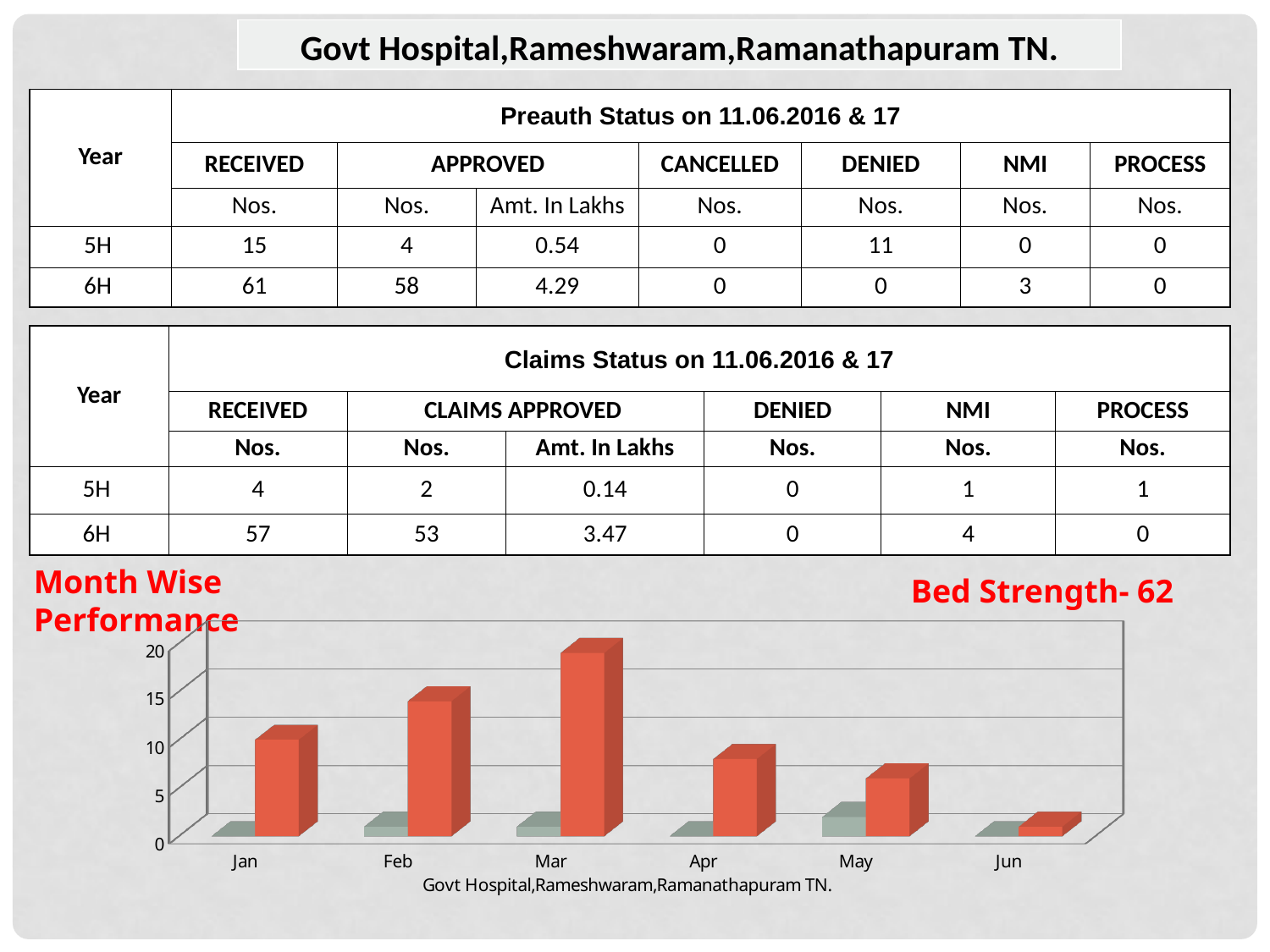
Is the red bar for Mar greater or less than 15? greater Is the red bar for Jan greater or less than 5? greater Is the red bar for Apr greater or less than 10? less Do the red bars rise or fall from Mar to Jun? fall What title is printed below the bar chart? Govt Hospital,Rameshwaram,Ramanathapuram TN. How many differently coloured sets of bars are plotted for each month in the chart? 2 What kind of chart is shown at the bottom of the slide? bar chart Which month has the tallest red bar in the chart? Mar Which month has a taller red bar, Feb or Apr? Feb Which month has the shortest red bar in the chart? Jun How many months are shown on the x axis of the bar chart? 6